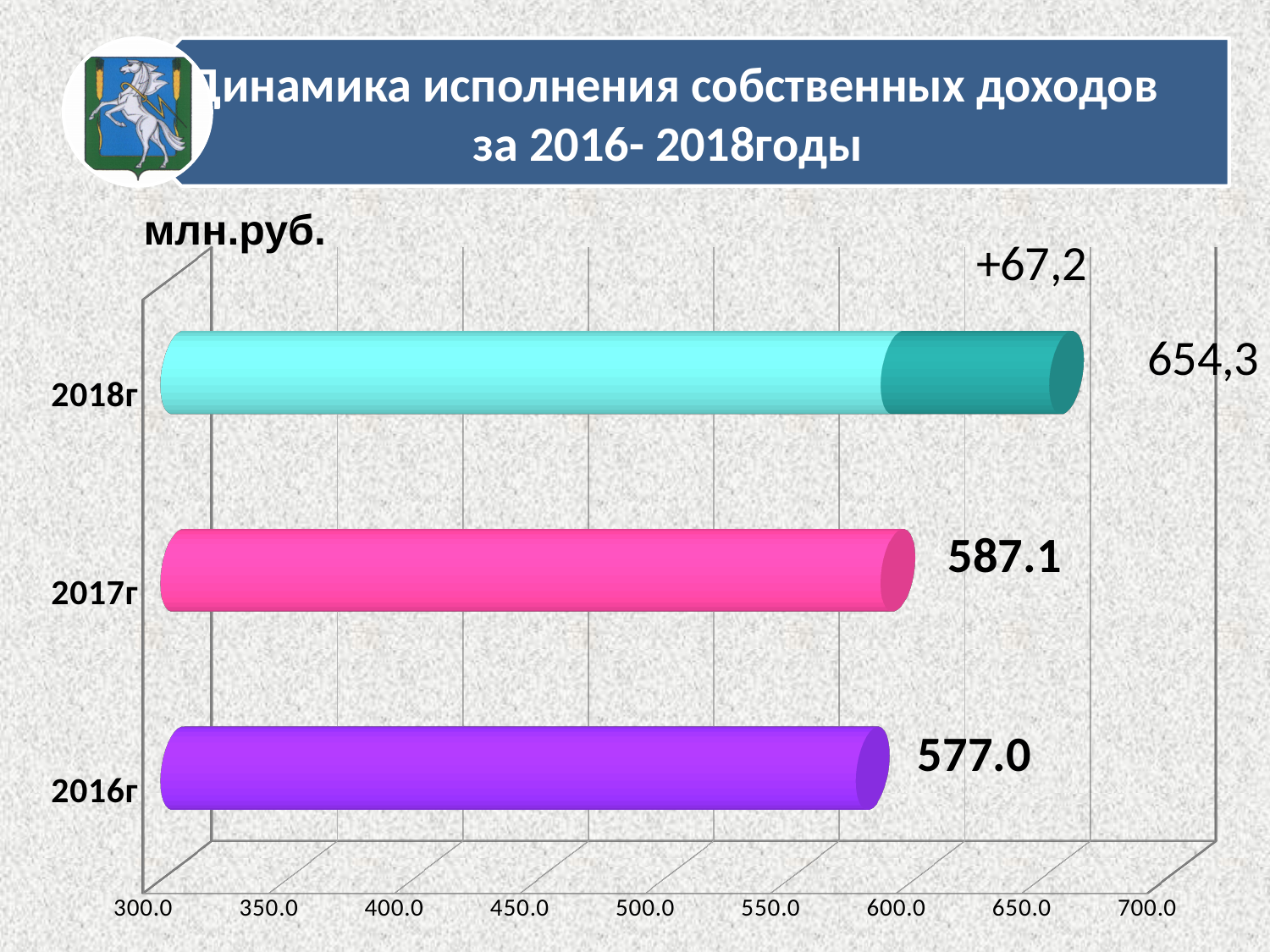
Which is larger, the value for 2018г or the value for 2017г? 2018г By how much does the value for 2018г exceed the value for 2017г? 67,2 What unit is indicated above the chart? млн.руб. Which year has the highest value? 2018г What is the value for 2016г? 577.0 What is the difference between the values for 2017г and 2016г? 10.1 What kind of chart is shown on the slide? bar chart How many years are shown in the chart? 3 What is the value for 2018г? 654,3 Which year has the lowest value? 2016г Is the value for 2016г greater or less than 550.0? greater What is the value for 2017г? 587.1